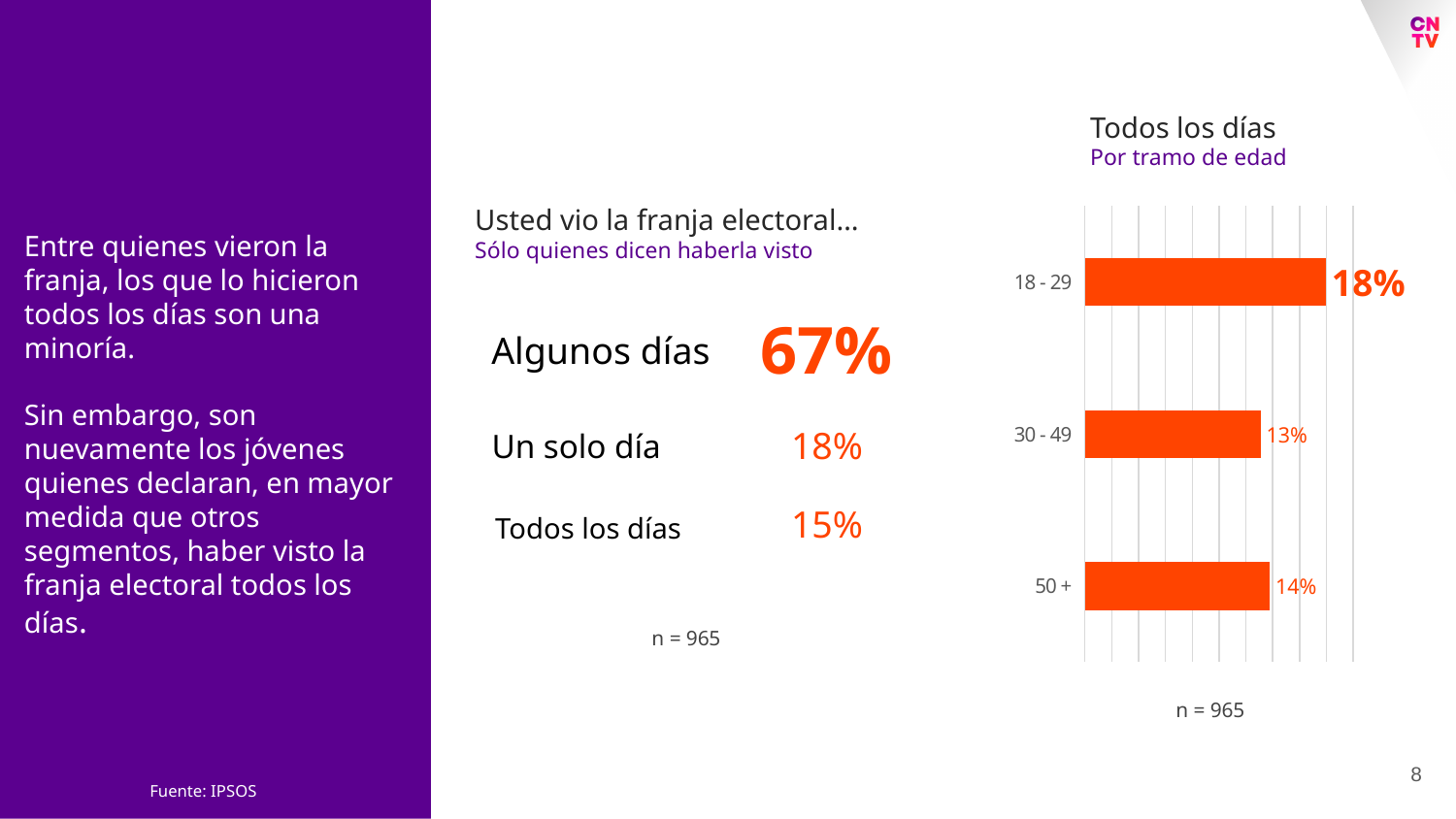
What kind of chart is the 'Todos los días' chart? Bar chart In the 'Todos los días' chart, what is the difference between the 18 - 29 and 30 - 49 values? 5% In the 'Todos los días' chart, which is larger: the value for 18 - 29 or the value for 50 +? 18 - 29 What is the value for the 18 - 29 age group in the 'Todos los días' chart? 18% What is the subtitle of the 'Todos los días' chart? Por tramo de edad What is the value for the 50 + age group in the 'Todos los días' chart? 14% In the 'Todos los días' chart, what is the difference between the 50 + and 30 - 49 values? 1% Which age group has the lowest value in the 'Todos los días' chart? 30 - 49 What sample size (n) is shown below the 'Todos los días' chart? n = 965 How many age groups are shown in the 'Todos los días' chart? 3 What is the value for the 30 - 49 age group in the 'Todos los días' chart? 13% Which age group has the highest value in the 'Todos los días' chart? 18 - 29